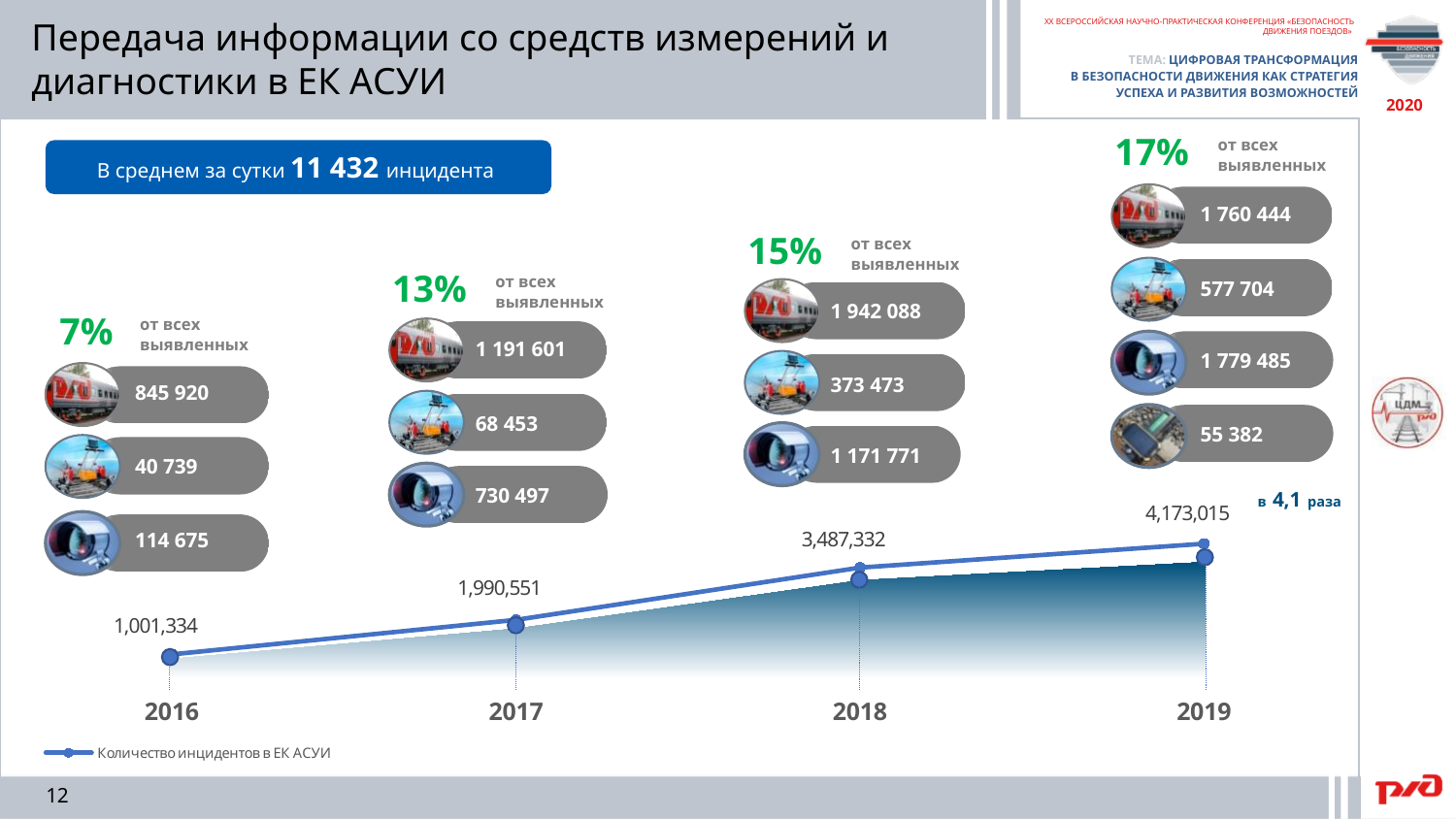
What kind of chart is shown at the bottom of the slide? Line chart Which is larger on the line chart, the value for 2018 or the value for 2017? 2018 What is the value for 2017 on the line chart? 1,990,551 What is the value for 2016 on the line chart? 1,001,334 Which year has the highest value on the line chart? 2019 What is the value for 2019 on the line chart? 4,173,015 What is the difference between the 2019 and 2018 values on the line chart? 685,683 What is the difference between the 2017 and 2016 values on the line chart? 989,217 Which year has the lowest value on the line chart? 2016 How many data points are plotted on the line chart? 4 What is the value for 2018 on the line chart? 3,487,332 Do the values on the line chart rise or fall from 2016 to 2019? Rise